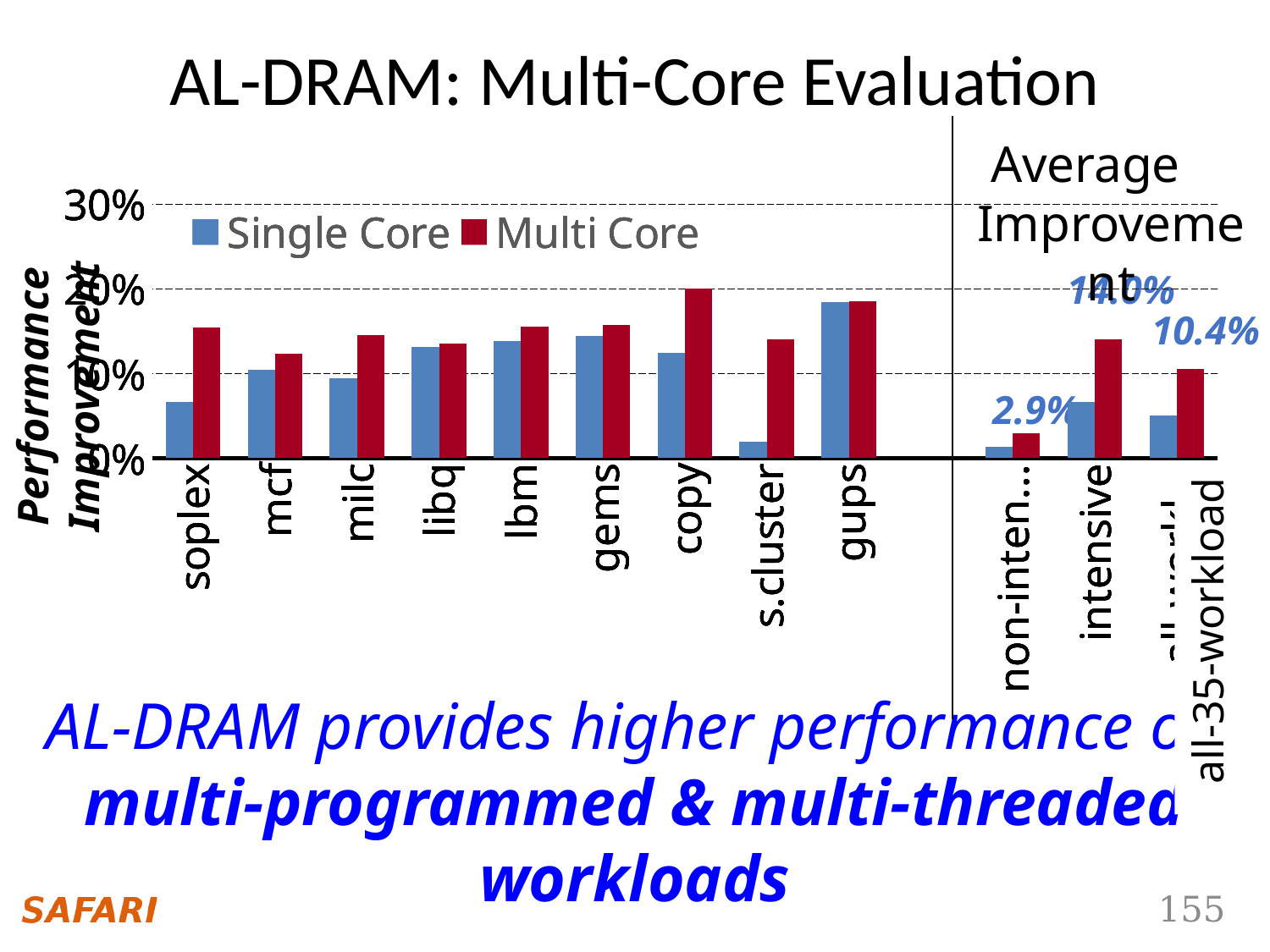
Is the Multi Core value for s.cluster greater or less than 10%? greater What is the title of the slide's chart? AL-DRAM: Multi-Core Evaluation What kind of chart is shown on the slide? bar chart Is the Single Core value for gups greater or less than 20%? less What is the difference between the labelled average improvement for all-35-workload (10.4%) and for non-intensive (2.9%)? 7.5% What average improvement value is labelled for the non-intensive category? 2.9% What are the two series named in the legend? Single Core and Multi Core For soplex, which is larger: the Single Core value or the Multi Core value? Multi Core How many series does the legend list? 2 Which category has the highest Multi Core value? copy What average improvement value is labelled for the all-35-workload category? 10.4% Which category has the highest Single Core value? gups